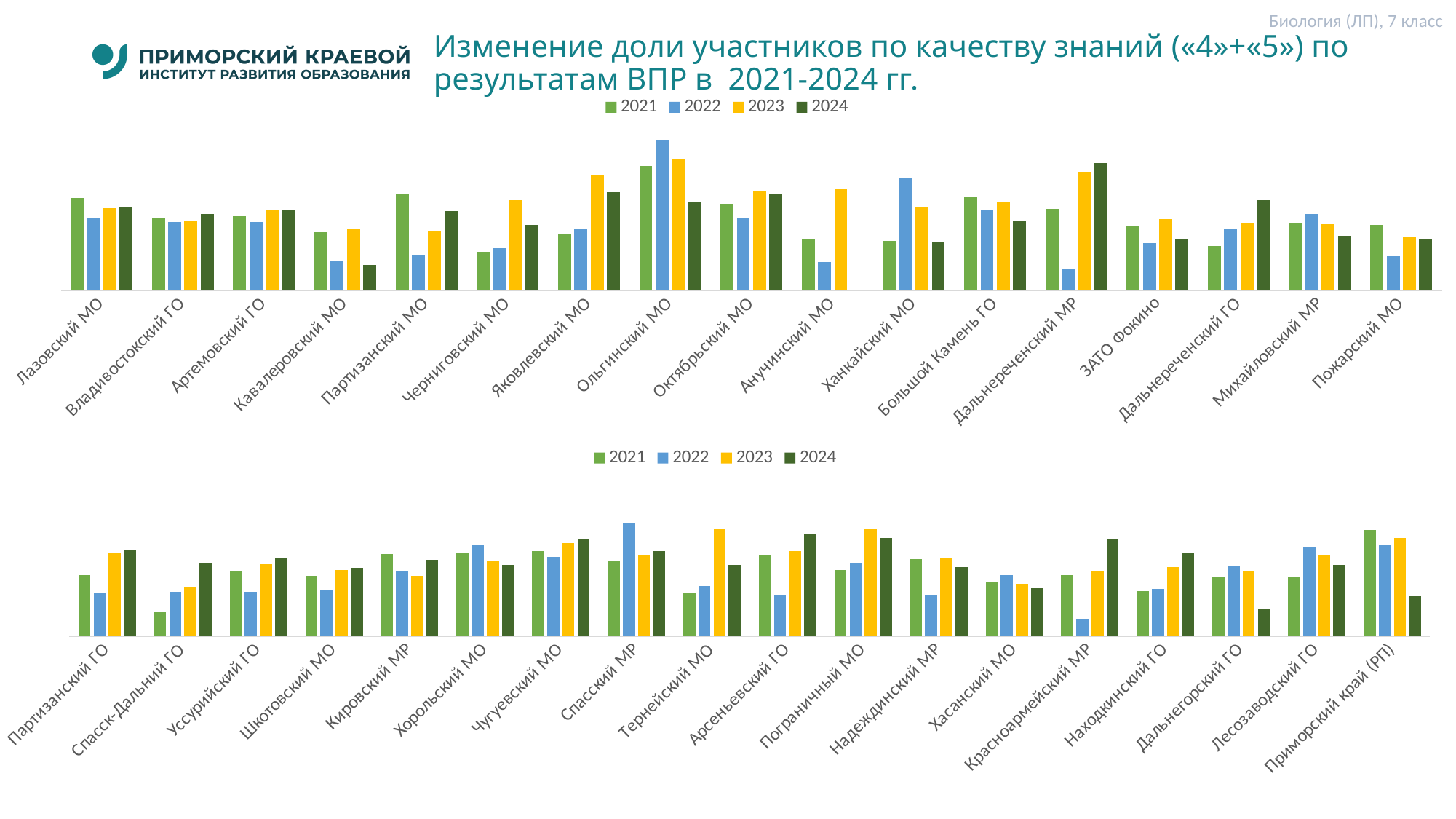
What kind of chart is the top chart on the slide? bar chart In the bottom chart, do the values for Спасск-Дальний ГО rise or fall from 2021 to 2024? rise How many categories are shown on the x axis of the bottom chart? 18 In the top chart, which category has the tallest bar overall? Ольгинский МО In the bottom chart, for Тернейский МО, which is larger: the 2021 value or the 2023 value? 2023 Which year does the yellow series in the legend represent? 2023 How many categories (municipalities) are shown on the x axis of the top chart? 17 In the bottom chart, for Дальнегорский ГО, which is larger: the 2022 value or the 2024 value? 2022 In the top chart, for Кавалеровский МО, which is larger: the 2021 value or the 2024 value? 2021 How many series does the legend of the top chart list? 4